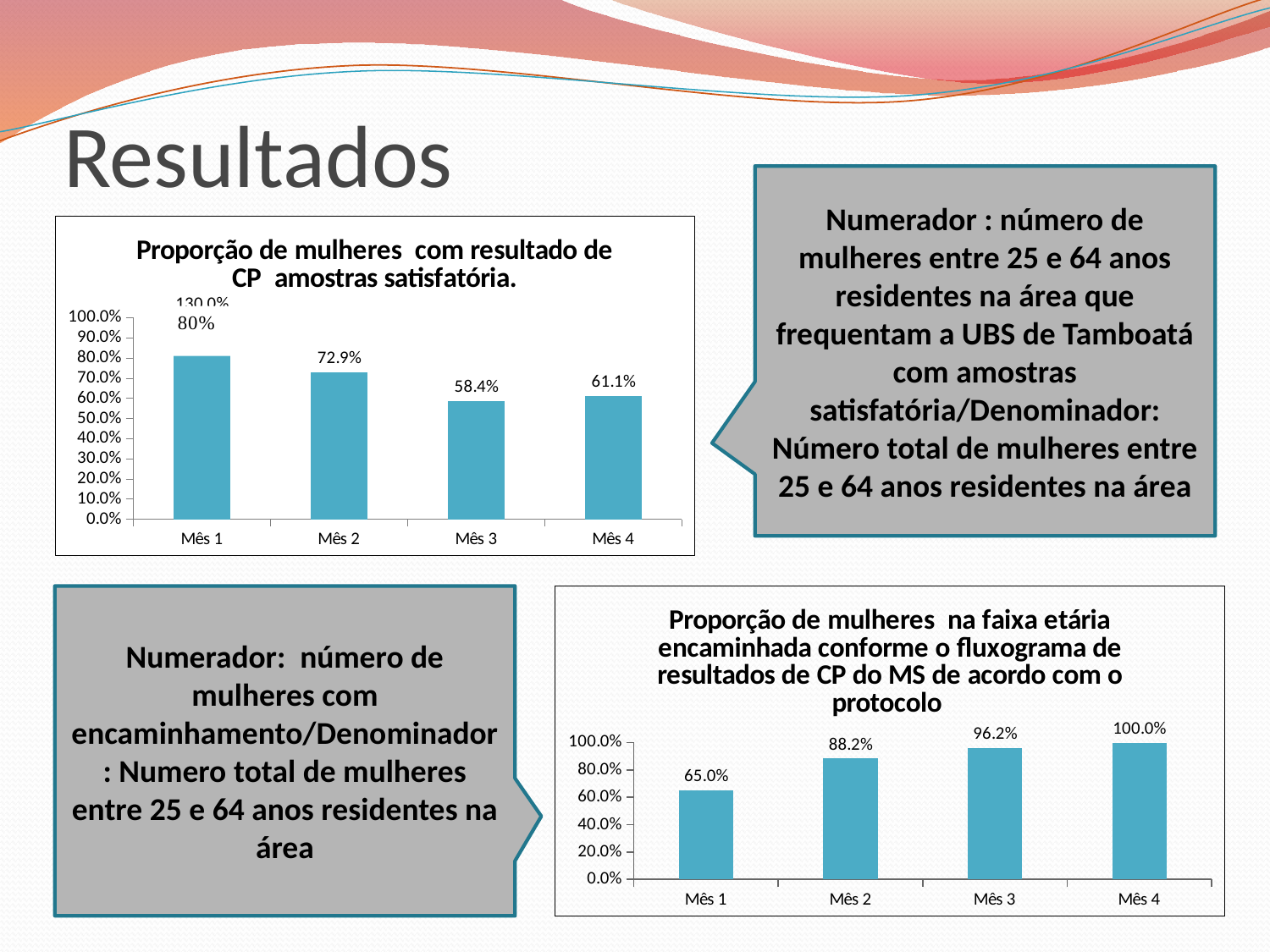
In the bottom-right chart (Proporção de mulheres na faixa etária encaminhada conforme o fluxograma), what is the difference between Mês 2 and Mês 1? 23.2% In the top-left chart (Proporção de mulheres com resultado de CP amostras satisfatória), is the value for Mês 1 greater or less than 70.0%? greater In the bottom-right chart (Proporção de mulheres na faixa etária encaminhada conforme o fluxograma), do the values rise or fall from Mês 1 to Mês 4? rise In the top-left chart (Proporção de mulheres com resultado de CP amostras satisfatória), which month has the lowest value? Mês 3 In the top-left chart (Proporção de mulheres com resultado de CP amostras satisfatória), what is the value for Mês 2? 72.9% In the bottom-right chart (Proporção de mulheres na faixa etária encaminhada conforme o fluxograma), which month has the highest value? Mês 4 In the top-left chart (Proporção de mulheres com resultado de CP amostras satisfatória), what is the value for Mês 3? 58.4% How many months are shown on the x axis of the bottom-right chart (Proporção de mulheres na faixa etária encaminhada conforme o fluxograma)? 4 In the bottom-right chart (Proporção de mulheres na faixa etária encaminhada conforme o fluxograma), what is the value for Mês 1? 65.0% In the top-left chart (Proporção de mulheres com resultado de CP amostras satisfatória), what is the difference between Mês 4 and Mês 3? 2.7% In the bottom-right chart (Proporção de mulheres na faixa etária encaminhada conforme o fluxograma), what is the value for Mês 3? 96.2% In the top-left chart (Proporção de mulheres com resultado de CP amostras satisfatória), which is larger, Mês 2 or Mês 4? Mês 2